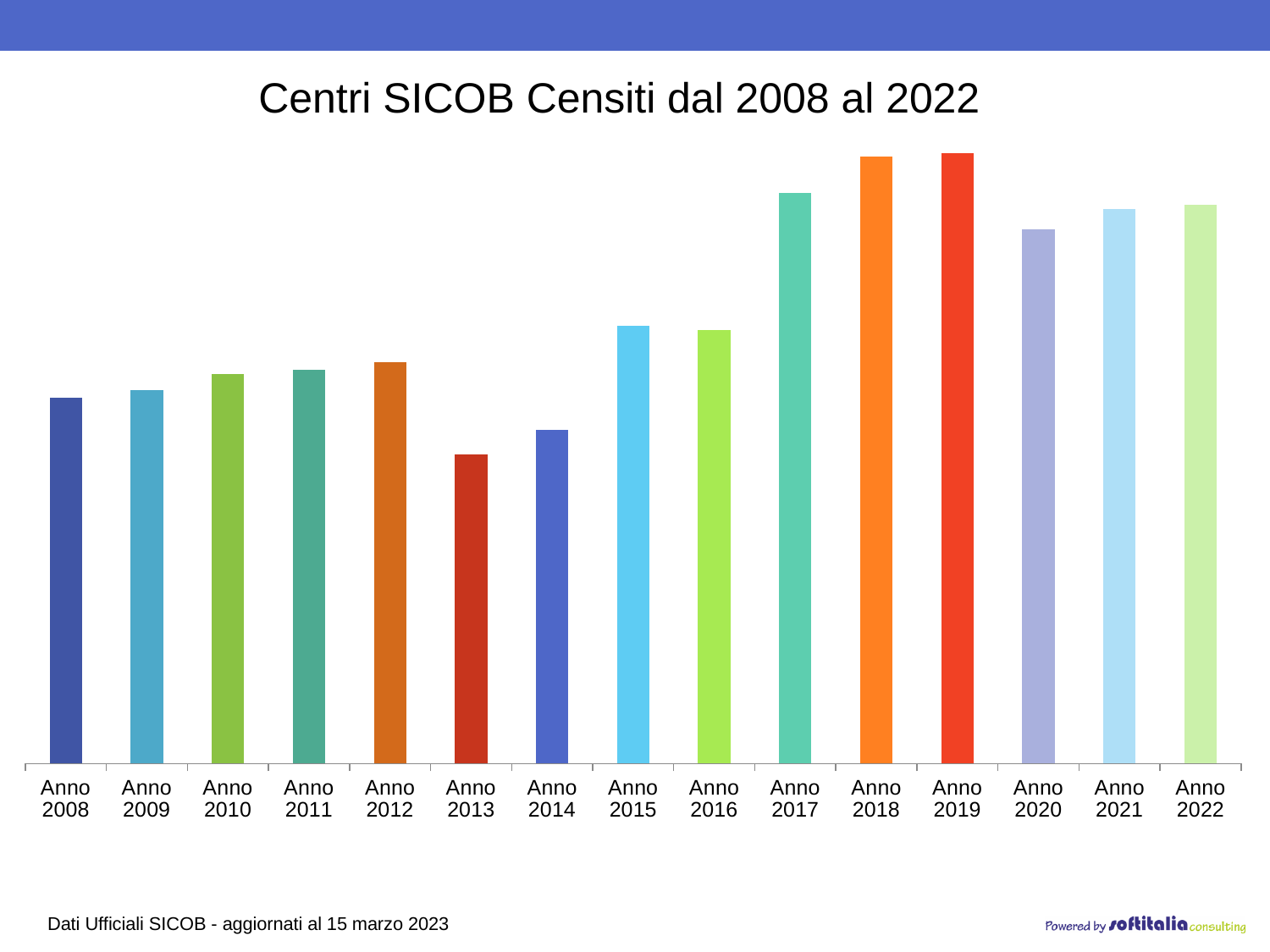
Which bar is taller, Anno 2017 or Anno 2020? Anno 2017 Which year has the lowest bar in the chart? Anno 2013 Which bar is taller, Anno 2008 or Anno 2010? Anno 2010 Do the bars rise or fall from Anno 2013 to Anno 2019? rise What is the title of the chart? Centri SICOB Censiti dal 2008 al 2022 How many years (bars) are shown in the chart? 15 What kind of chart is shown on the slide? bar chart Which bar is taller, Anno 2013 or Anno 2014? Anno 2014 Do the bars rise or fall from Anno 2008 to Anno 2012? rise What word precedes each year in the x-axis labels? Anno